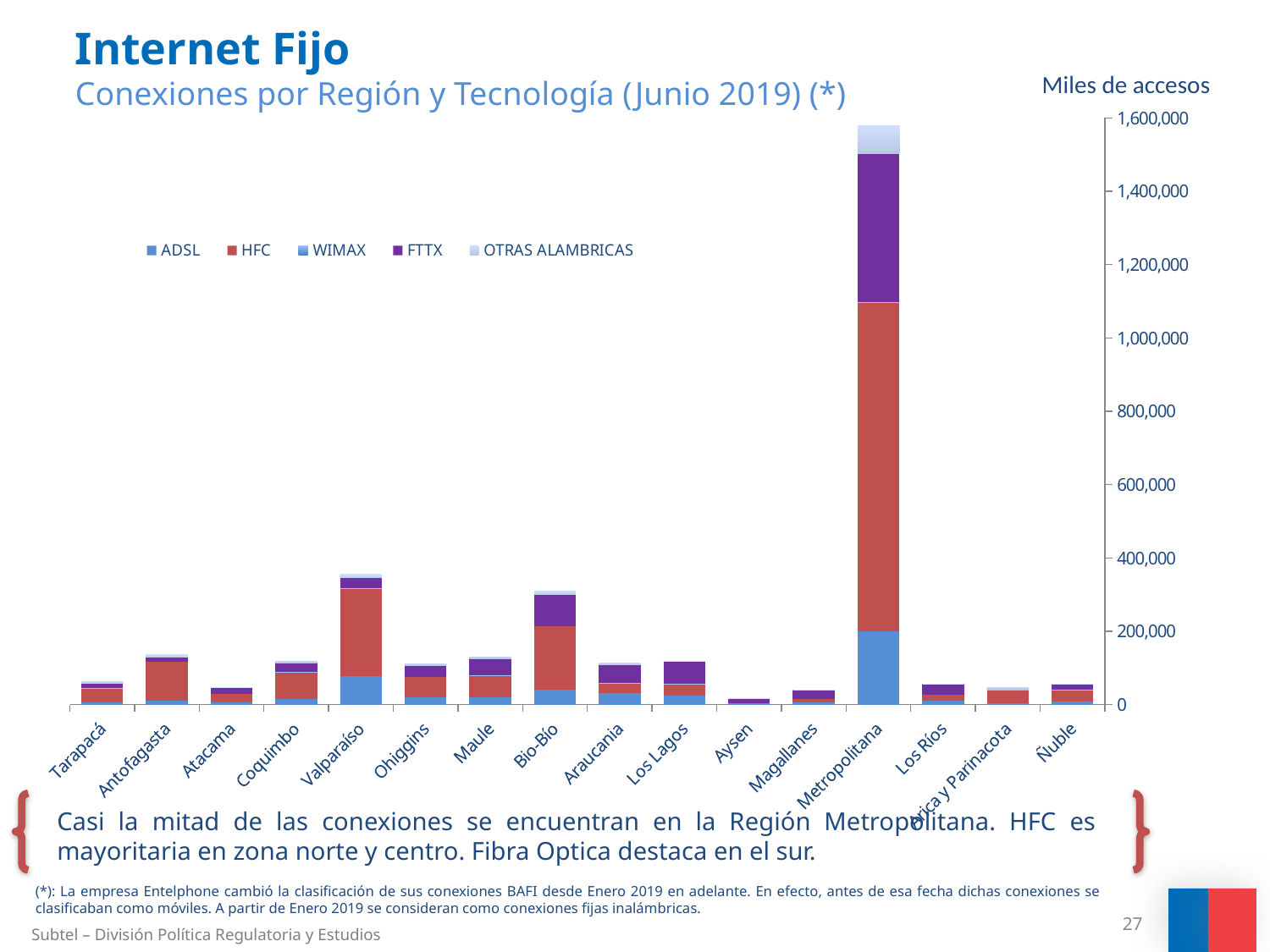
Which series is shown in red in the legend? HFC What unit is indicated for the y axis? Miles de accesos Which region has the highest total number of connections? Metropolitana Is the total for Metropolitana greater or less than 1,400,000? greater How many series does the legend list? 5 Which region has a larger total, Valparaíso or Antofagasta? Valparaíso How many regions are shown on the x axis? 16 Which region has the lowest total number of connections? Aysen Is the total for Valparaíso greater or less than 400,000? less Is the total for Bio-Bío greater or less than 200,000? greater What kind of chart is shown on the slide? Stacked bar chart